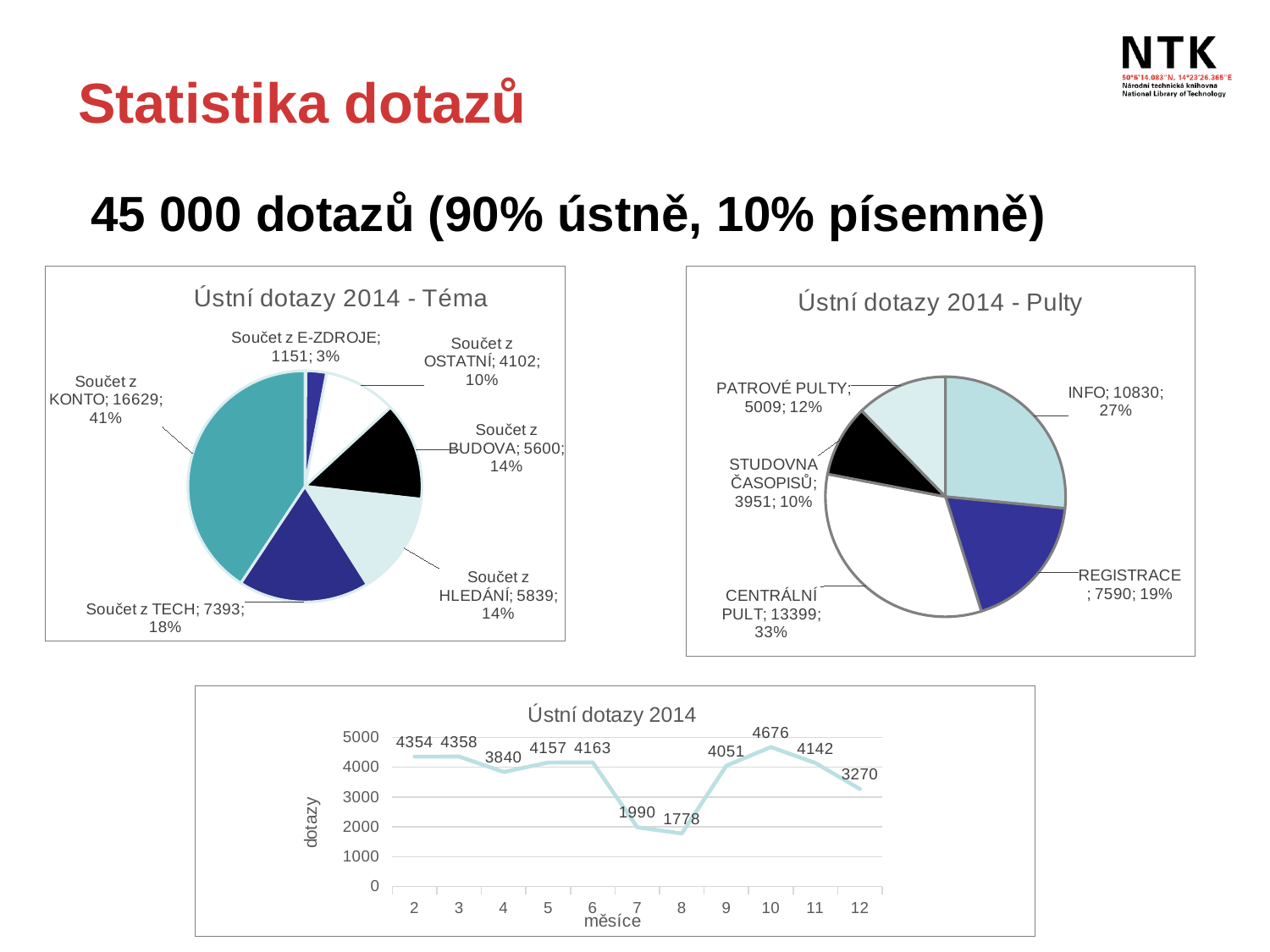
In the 'Ústní dotazy 2014 - Pulty' pie chart, which is larger, PATROVÉ PULTY or STUDOVNA ČASOPISŮ? PATROVÉ PULTY In the 'Ústní dotazy 2014 - Téma' pie chart, how many slices are there? 6 What type of chart is the 'Ústní dotazy 2014' chart at the bottom of the slide? line chart In the 'Ústní dotazy 2014 - Téma' pie chart, what share does Součet z TECH have? 18% In the 'Ústní dotazy 2014' chart at the bottom, which month has the lowest value? 8 In the 'Ústní dotazy 2014' chart at the bottom, what is the difference between month 2 and month 12? 1084 In the 'Ústní dotazy 2014' chart at the bottom, what is the value for month 10? 4676 In the 'Ústní dotazy 2014 - Téma' pie chart, what is the value for Součet z KONTO? 16629 In the 'Ústní dotazy 2014 - Pulty' pie chart, what is the value for CENTRÁLNÍ PULT? 13399 In the 'Ústní dotazy 2014 - Pulty' pie chart, what is the difference between INFO and REGISTRACE? 3240 In the 'Ústní dotazy 2014 - Pulty' pie chart, what share does INFO have? 27%